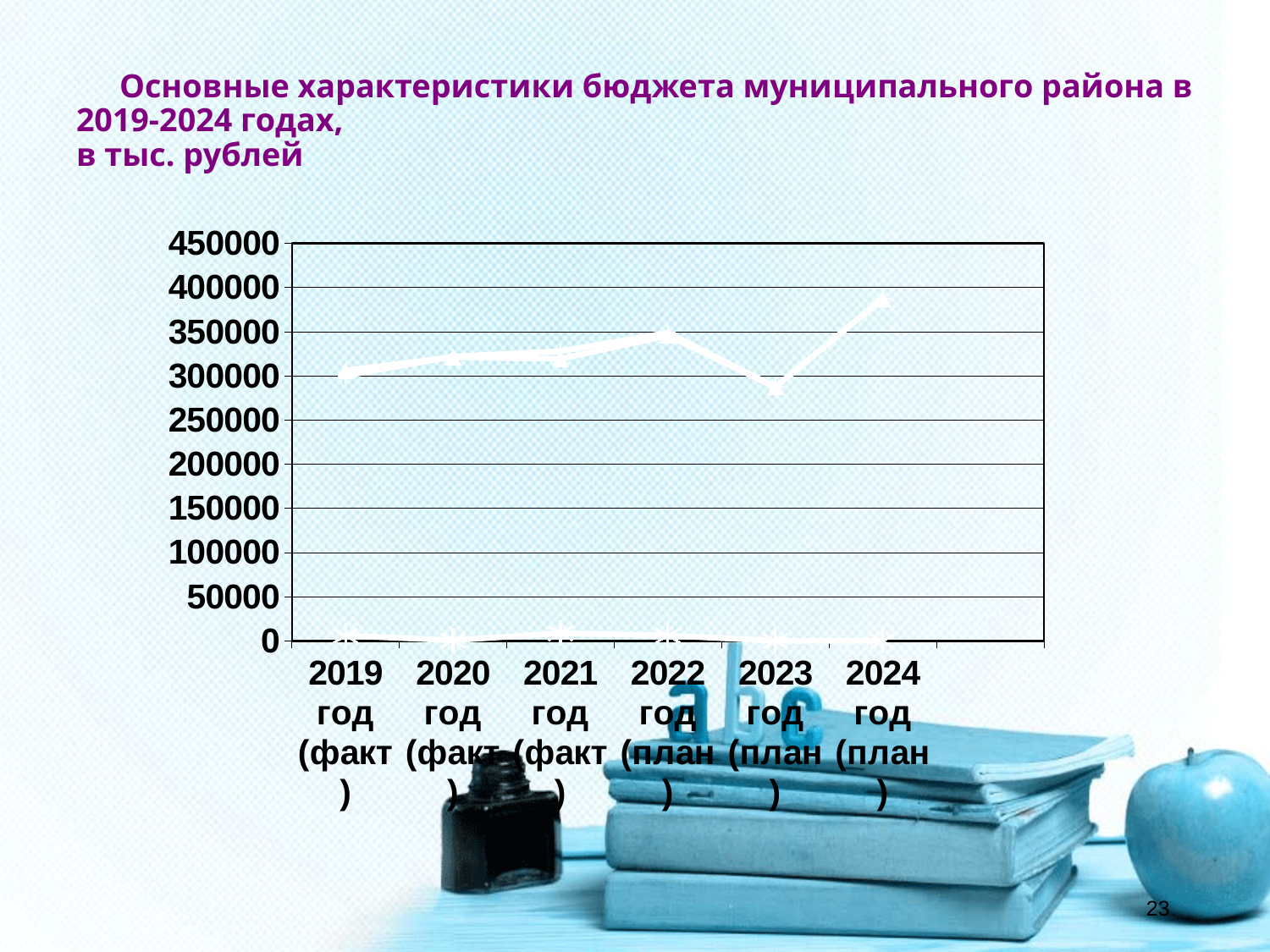
What is the highest value shown on the vertical axis of the chart? 450000 Which year has the highest value on the chart? 2024 год (план) Which is larger on the upper line: the value for 2022 год (план) or the value for 2023 год (план)? 2022 год (план) Does the upper line rise or fall from 2022 год (план) to 2023 год (план)? falls Is the value for 2020 год (факт) on the upper line greater or less than 350000? less What kind of chart is shown on the slide? line chart Is the value for 2024 год (план) on the upper line greater or less than 350000? greater How many years (categories) are shown on the x axis of the chart? 6 Which is larger on the upper line: the value for 2024 год (план) or the value for 2019 год (факт)? 2024 год (план) Is the value for 2021 год (факт) on the upper line greater or less than 300000? greater How many of the years on the x axis are labelled as план (plan)? 3